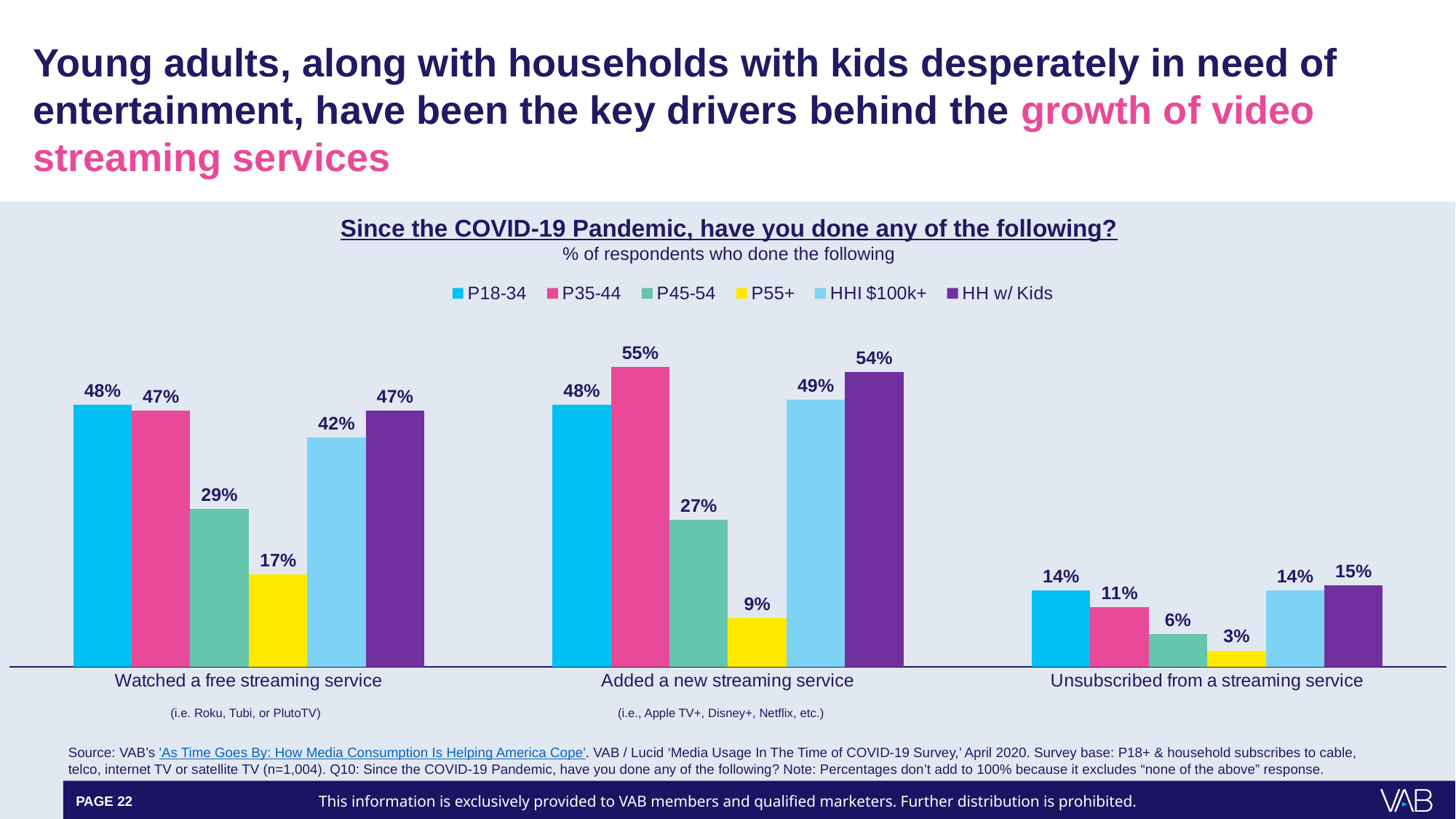
What percentage of P35-44 respondents added a new streaming service? 55% How many categories are shown on the x axis? 3 What percentage of P55+ respondents unsubscribed from a streaming service? 3% What is the value for HH w/ Kids in the 'Added a new streaming service' category? 54% Which is larger for 'Unsubscribed from a streaming service': the P18-34 value or the P35-44 value? P18-34 Which series has the highest value for 'Added a new streaming service'? P35-44 What percentage of P18-34 respondents watched a free streaming service? 48% Which series has the lowest value for 'Watched a free streaming service'? P55+ How many series does the legend list? 6 What is the title of the chart? Since the COVID-19 Pandemic, have you done any of the following? What is the difference between the P18-34 and P45-54 values for 'Watched a free streaming service'? 19 percentage points What kind of chart is shown on the slide? Bar chart